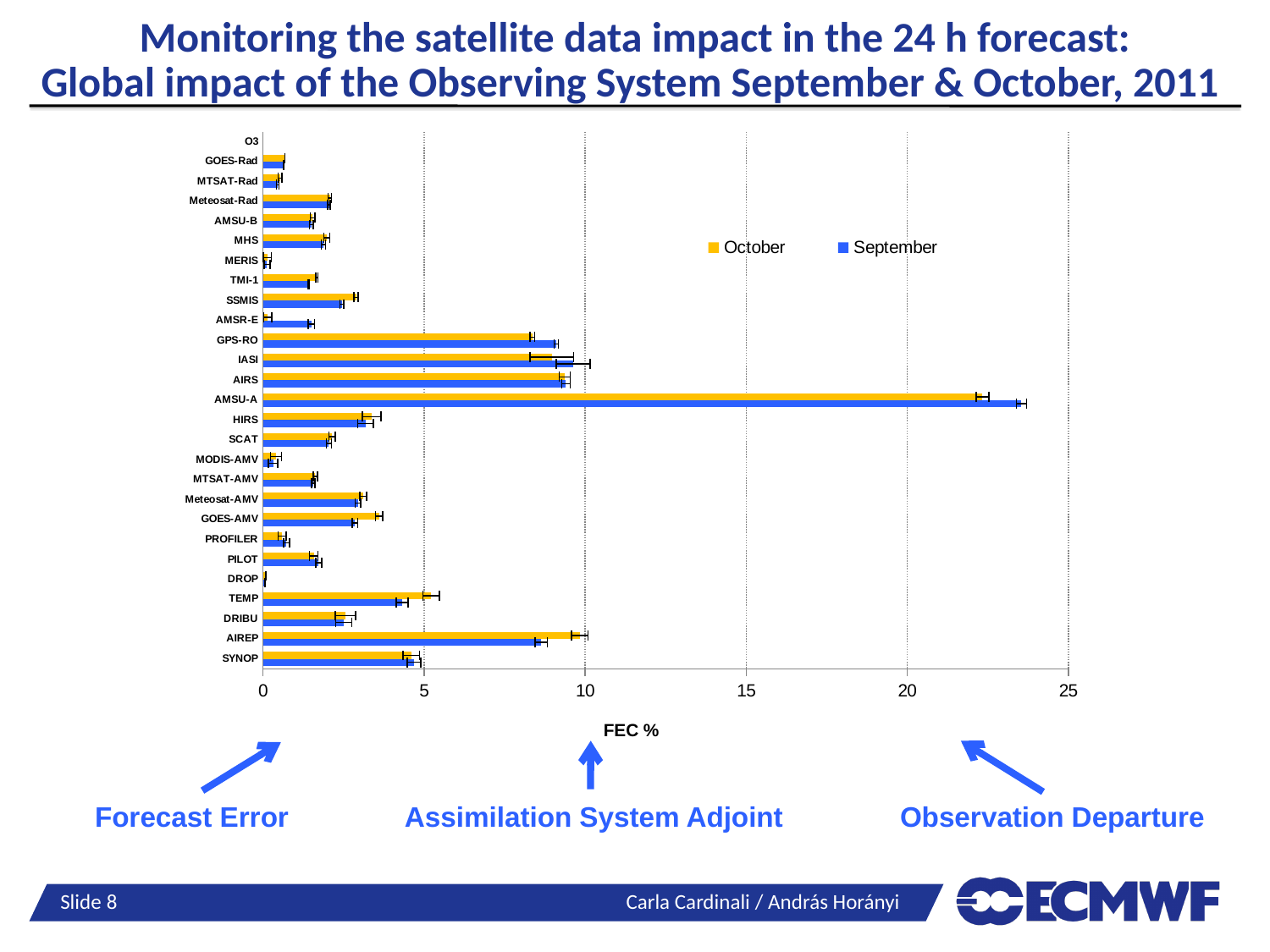
How many series does the legend list? 2 What kind of chart is shown on the slide? bar chart What is the title of the x axis? FEC % For AMSU-A, which series has the larger value, October or September? September Is the October value for GPS-RO greater or less than 10? less How many observation categories are plotted on the y axis? 27 Is the September value for AMSU-A greater or less than 20? greater Is the September value for AIRS greater or less than 5? greater Which category has the highest FEC % value? AMSU-A For AIREP, which series has the larger value, October or September? October Which colour represents the September series in the legend? blue